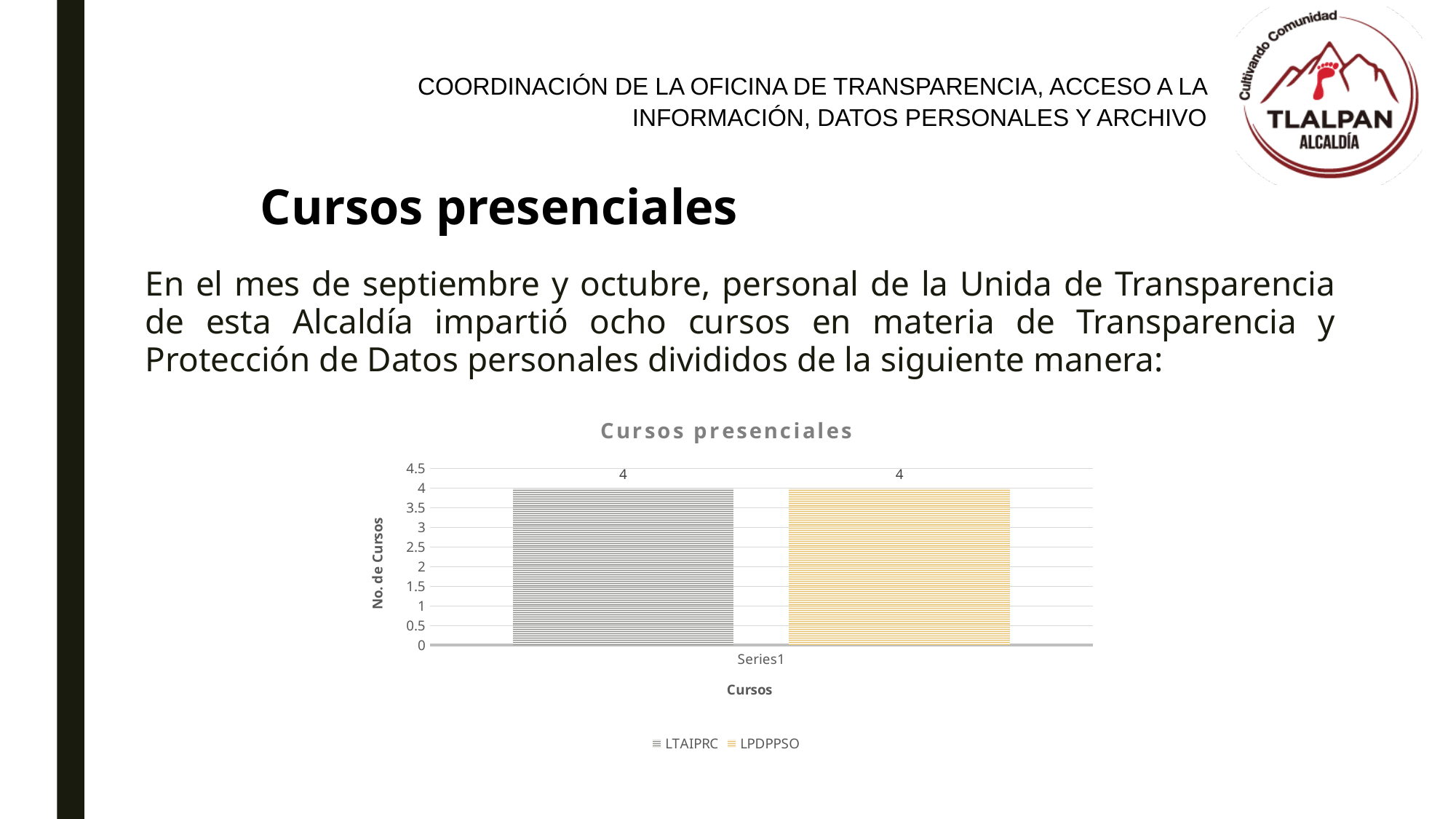
Is the value for LPDPPSO greater or less than 4.5? less What is the value for LPDPPSO in the chart? 4 What is the value for LTAIPRC in the chart? 4 How many categories are shown on the x axis of the chart? 1 Is the value for LTAIPRC greater or less than 3? greater What is the label of the vertical axis of the chart? No. de Cursos How many series does the chart legend list? 2 What is the title of the chart? Cursos presenciales What is the difference between the values for LTAIPRC and LPDPPSO? 0 What kind of chart is shown on the slide? bar chart